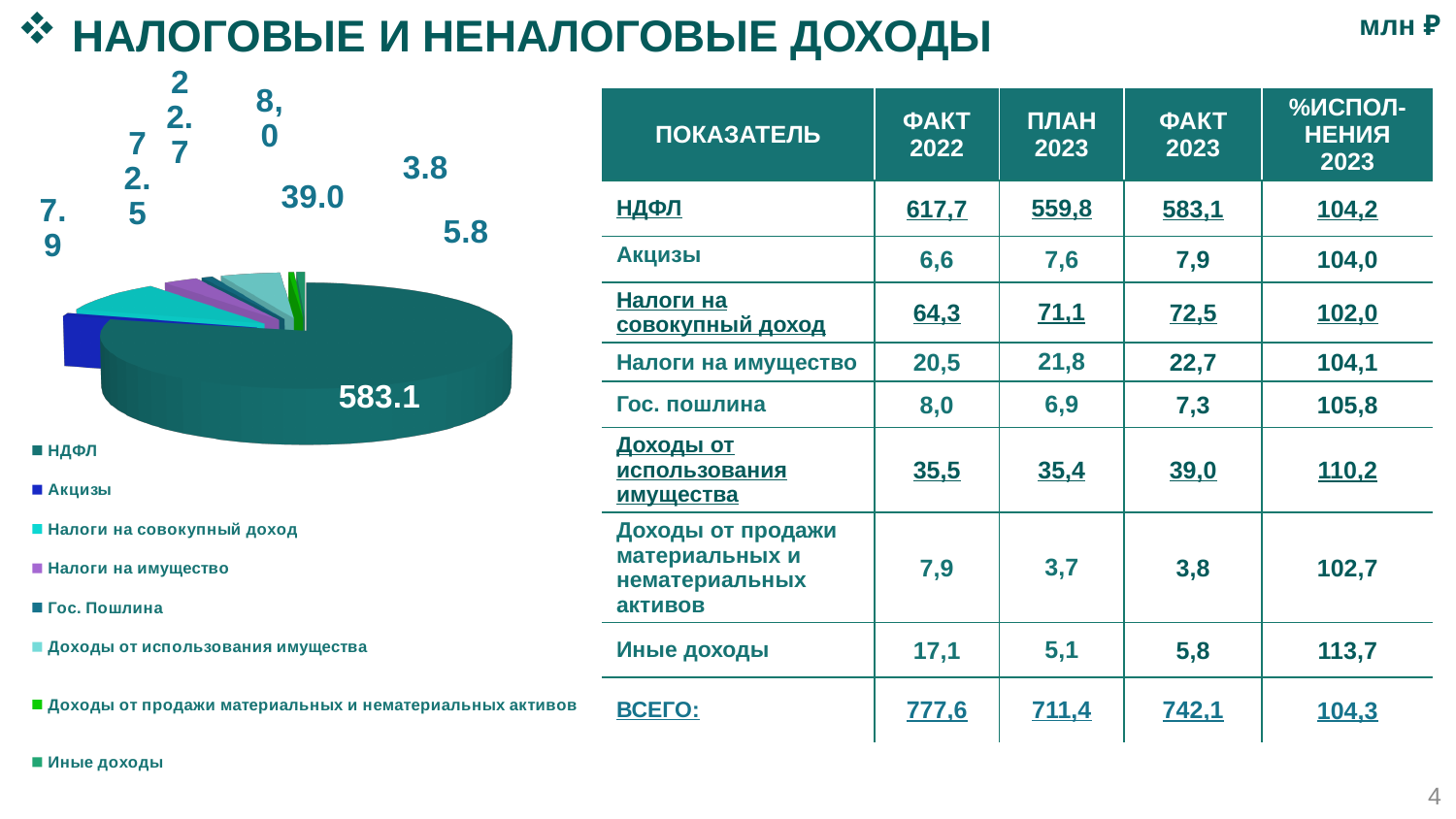
In the pie chart, which is larger: Доходы от использования имущества or Иные доходы? Доходы от использования имущества What value is labelled on the Иные доходы slice of the pie chart? 5.8 What kind of chart is shown on the left of the slide? pie chart What value is labelled on the НДФЛ slice of the pie chart? 583.1 In the pie chart, what is the difference between the Доходы от использования имущества value (39.0) and the Доходы от продажи материальных и нематериальных активов value (3.8)? 35.2 How many categories does the pie chart's legend list? 8 What value is labelled on the Акцизы slice of the pie chart? 7.9 What value is labelled on the Доходы от использования имущества slice of the pie chart? 39.0 What value is labelled on the Доходы от продажи материальных и нематериальных активов slice of the pie chart? 3.8 Which category has the largest slice in the pie chart? НДФЛ What is the title of the slide containing the pie chart? НАЛОГОВЫЕ И НЕНАЛОГОВЫЕ ДОХОДЫ Which category has the smallest labelled value in the pie chart? Доходы от продажи материальных и нематериальных активов